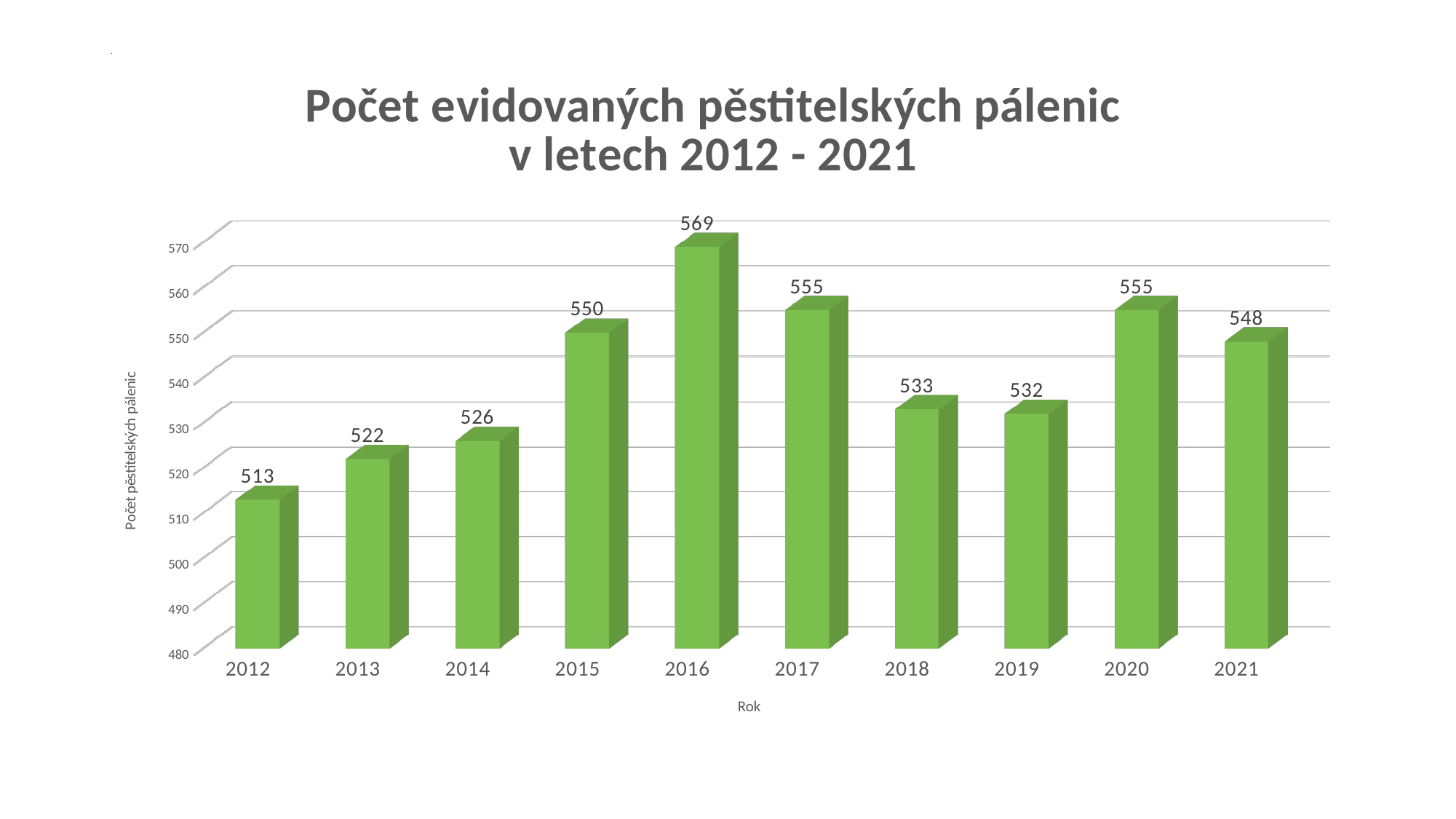
Which year has the lowest value? 2012 What is the title of the chart? Počet evidovaných pěstitelských pálenic v letech 2012 - 2021 What is the difference between the values for 2021 and 2020? 7 What kind of chart is shown on the slide? bar chart How many years are shown on the x axis? 10 What is the difference between the values for 2016 and 2012? 56 What is the value for 2012? 513 What is the value for 2016? 569 What is the value for 2019? 532 Is the value for 2014 greater or less than 530? less Which year has the highest value? 2016 Which is larger, the value for 2015 or the value for 2018? 2015